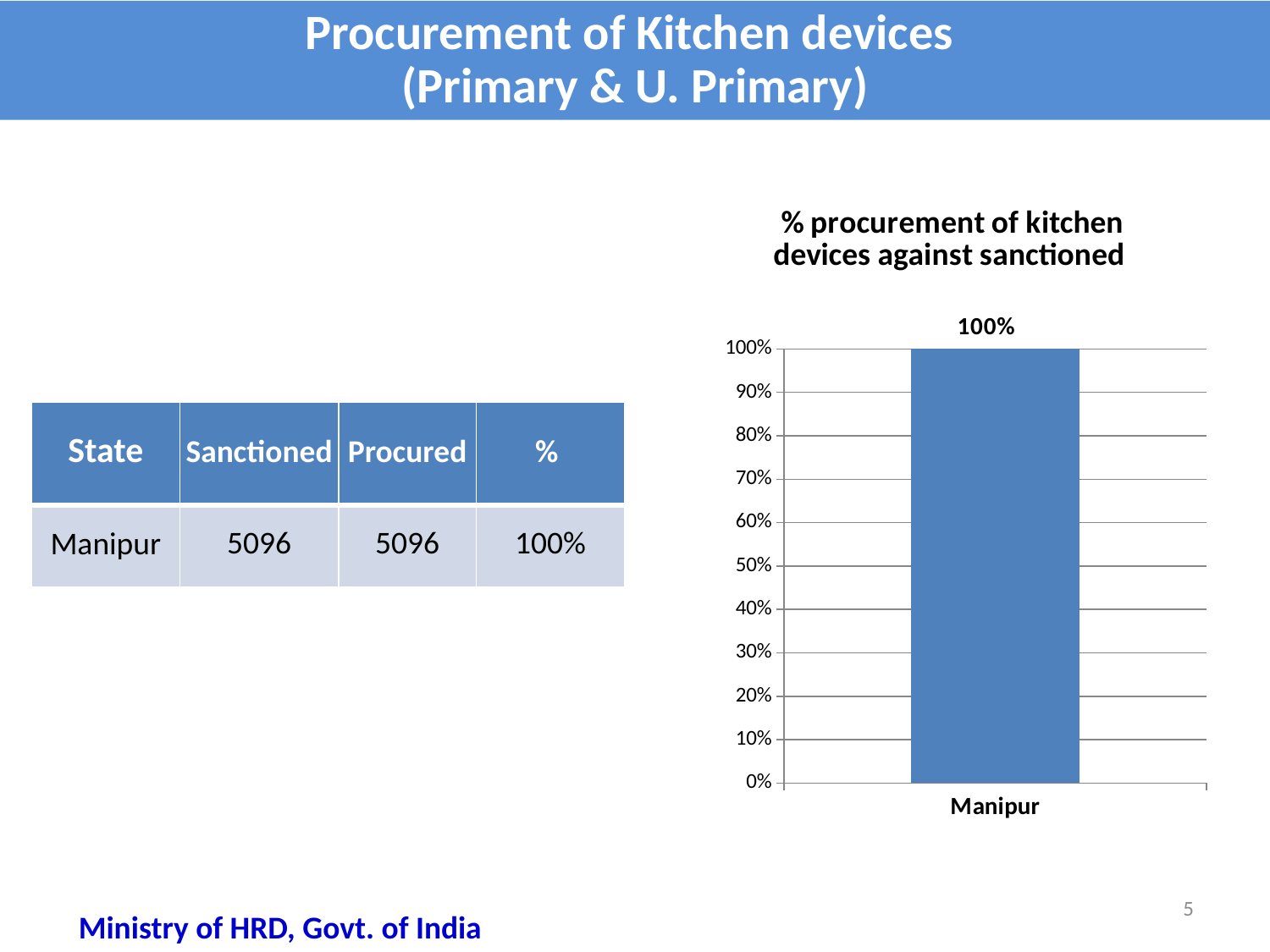
What kind of chart is shown on the slide? bar chart How many categories are plotted in the chart? 1 What is the highest value shown on the y axis of the chart? 100% What is the title of the chart? % procurement of kitchen devices against sanctioned Which category is shown on the x axis of the chart? Manipur Is the value for Manipur greater or less than 90%? greater Is the value for Manipur greater or less than 50%? greater What is the value for Manipur in the chart? 100%